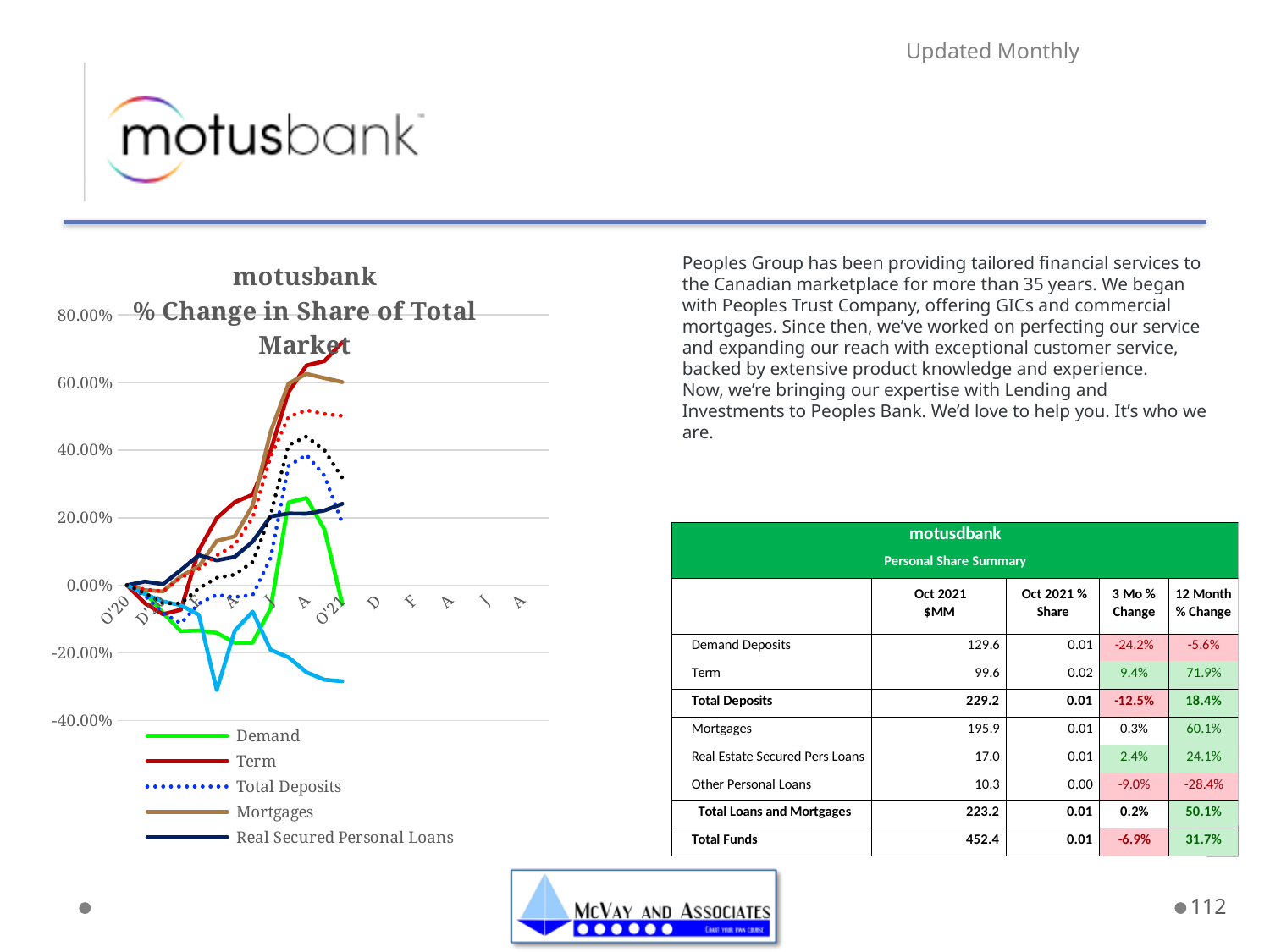
Is the value for Mortgages at O'21 greater or less than 40.00%? greater At O'21, which series is higher, Term or Demand? Term What kind of chart is shown on the slide? line chart How many series does the chart legend list? 5 How many labels are shown along the x axis of the chart? 12 At O'21, which series is higher, Term or Mortgages? Term Is the value for Term at O'21 greater or less than 60.00%? greater Is the value for Real Secured Personal Loans at O'21 greater or less than 0.00%? greater Does the Term series overall rise or fall from O'20 to O'21? rise What is the title of the chart? motusbank % Change in Share of Total Market Which series is listed last in the chart legend? Real Secured Personal Loans